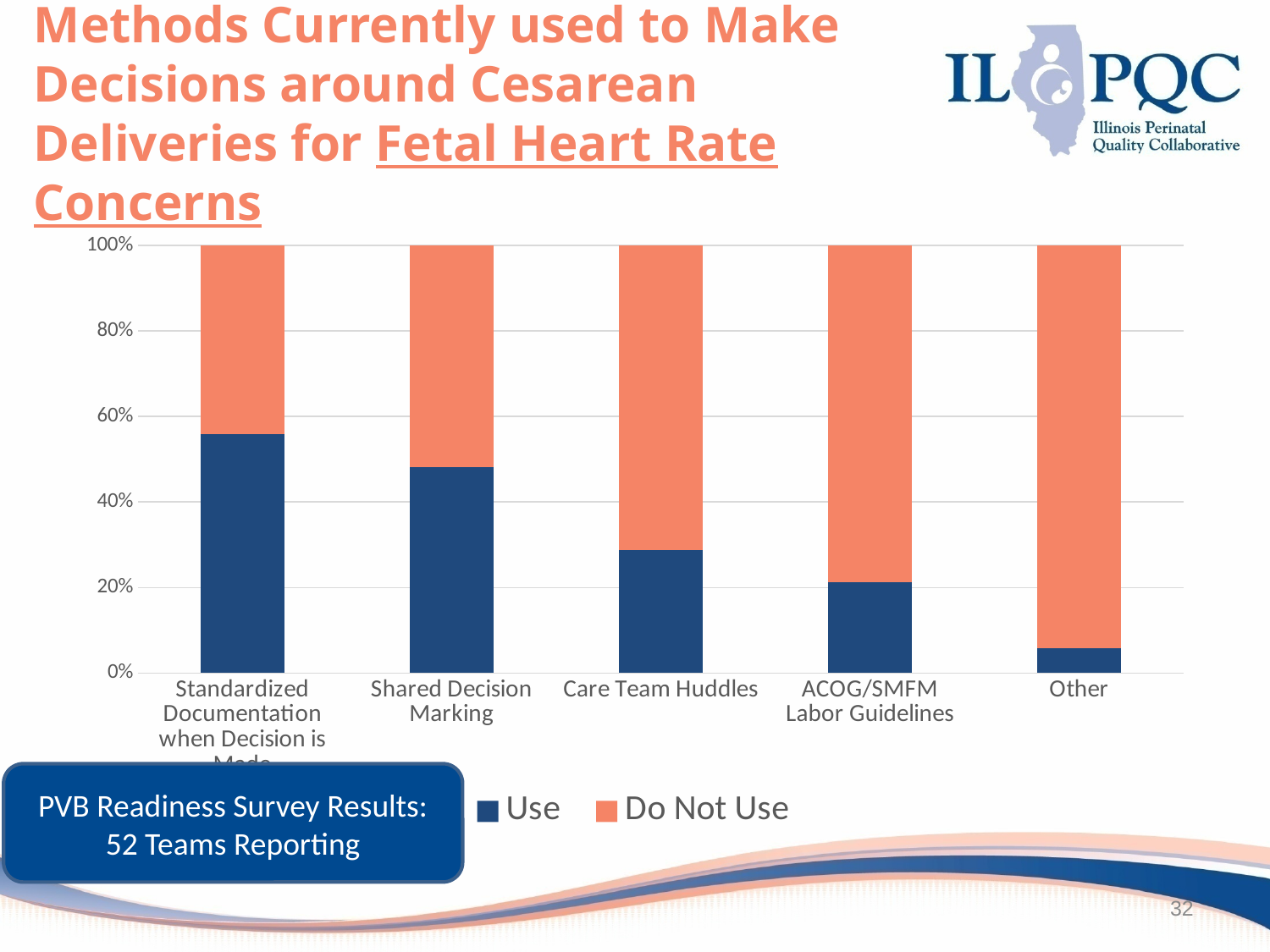
Is the 'Use' value for ACOG/SMFM Labor Guidelines greater or less than 40%? less Which has a larger 'Use' share: Shared Decision Marking or Care Team Huddles? Shared Decision Marking Is the 'Use' value for Standardized Documentation when Decision is Made greater or less than 40%? greater How many series does the chart's legend list? 2 Which category has the highest 'Use' share? Standardized Documentation when Decision is Made Which category has the lowest 'Use' share? Other How many categories are shown along the x axis of the chart? 5 Does the 'Use' share rise or fall moving from left to right across the categories? fall Which colour represents 'Do Not Use' in the chart? Orange What kind of chart is shown on the slide? Stacked bar chart What is the total height of each stacked bar in the chart? 100% Is the 'Use' value for Care Team Huddles greater or less than 40%? less